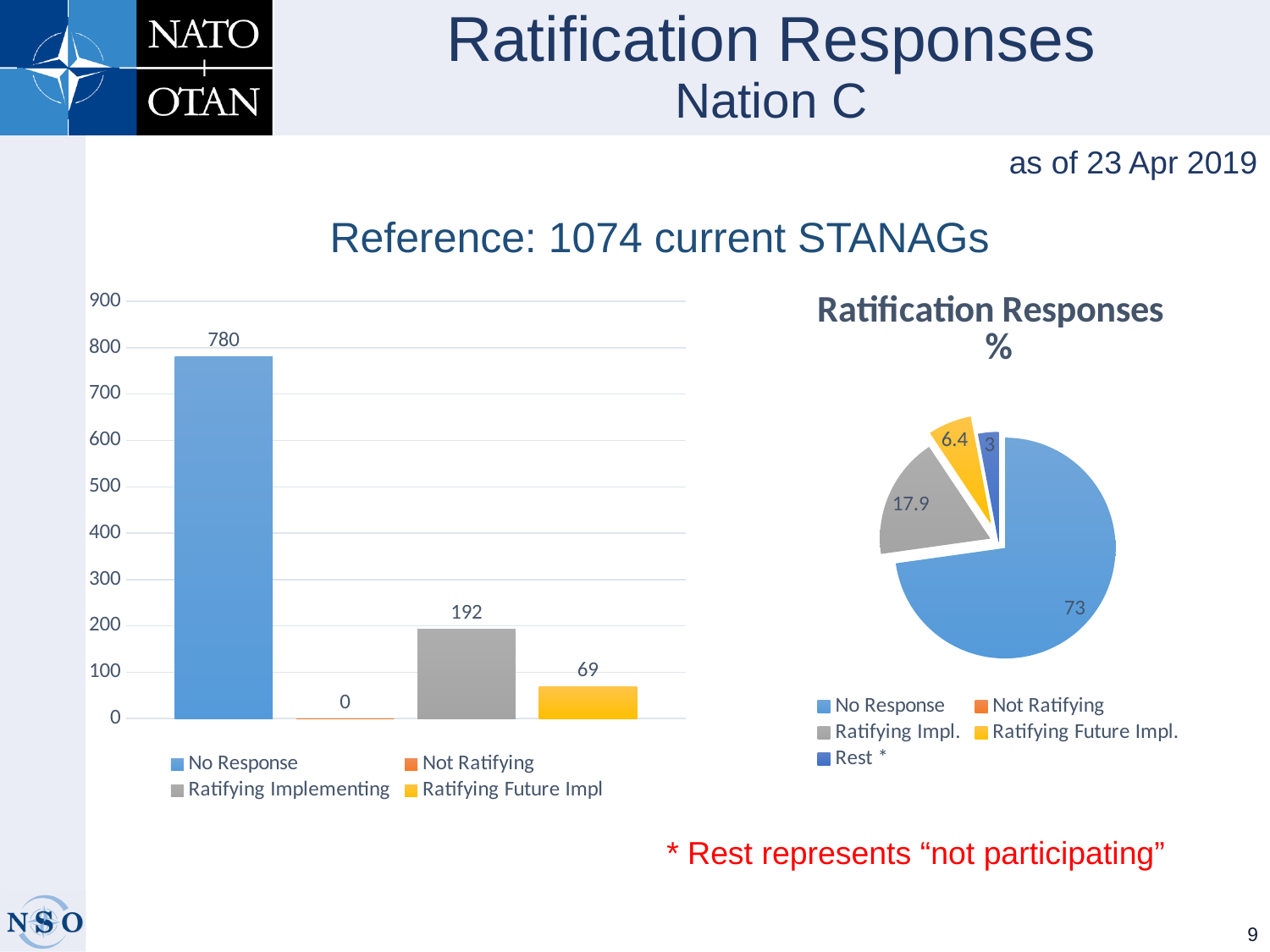
In the bar chart on the left, which category has the lowest value? Not Ratifying In the bar chart on the left, how many categories are shown in the legend? 4 In the pie chart titled 'Ratification Responses %', what is the value shown for the No Response slice? 73 In the bar chart on the left, what is the value for Ratifying Implementing? 192 In the bar chart on the left, which is larger: Ratifying Implementing or Ratifying Future Impl? Ratifying Implementing In the bar chart on the left, what is the value for Ratifying Future Impl? 69 In the bar chart on the left, what is the difference between the No Response value and the Ratifying Implementing value? 588 In the bar chart on the left, what is the value for No Response? 780 What kind of chart is the chart on the left of the slide? Bar chart In the bar chart on the left, which category has the highest value? No Response In the pie chart titled 'Ratification Responses %', how many entries does the legend list? 5 In the pie chart titled 'Ratification Responses %', what is the value shown for the Ratifying Impl. slice? 17.9